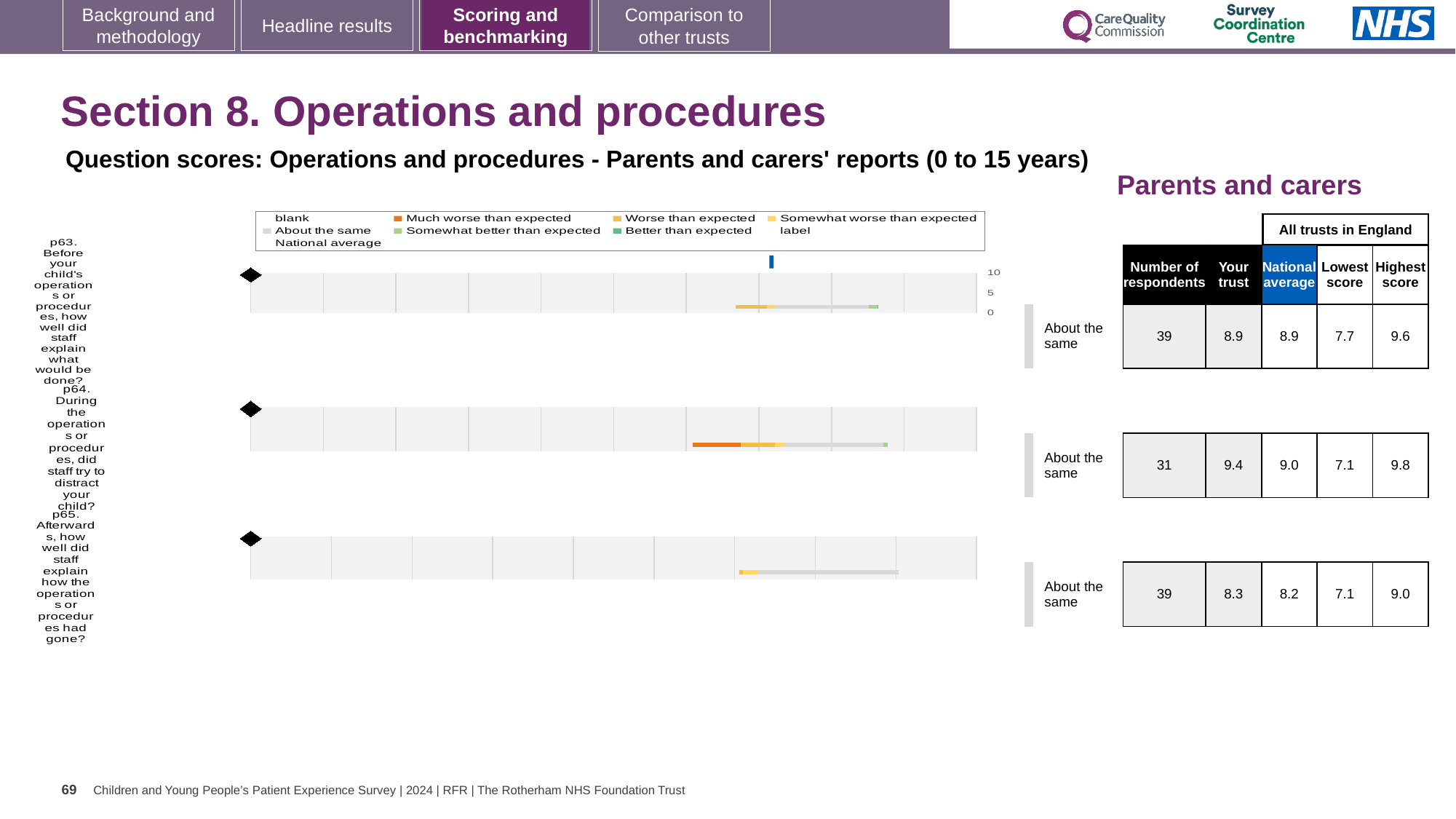
What kind of chart is used to show the question scores for p63, p64 and p65? bar chart What is the 'Your trust' score for p64 (During the operations or procedures, did staff try to distract your child?)? 9.4 What is the highest score among all trusts in England for p64? 9.8 What is the national average score for p65 (Afterwards, how well did staff explain how the operations or procedures had gone?)? 8.2 Which question has the lowest 'Your trust' score? p65 Which question has the highest 'Your trust' score? p64 How many respondents answered p63 (Before your child's operations or procedures, how well did staff explain what would be done?)? 39 For p63, is the 'Your trust' score higher than, lower than, or the same as the national average? the same What is the difference between the 'Your trust' score and the national average for p64? 0.4 What is the lowest score among all trusts in England for p63? 7.7 What benchmark category is shown for all three questions (p63, p64, p65)? About the same How many questions (p63, p64, p65) are plotted on the slide? 3